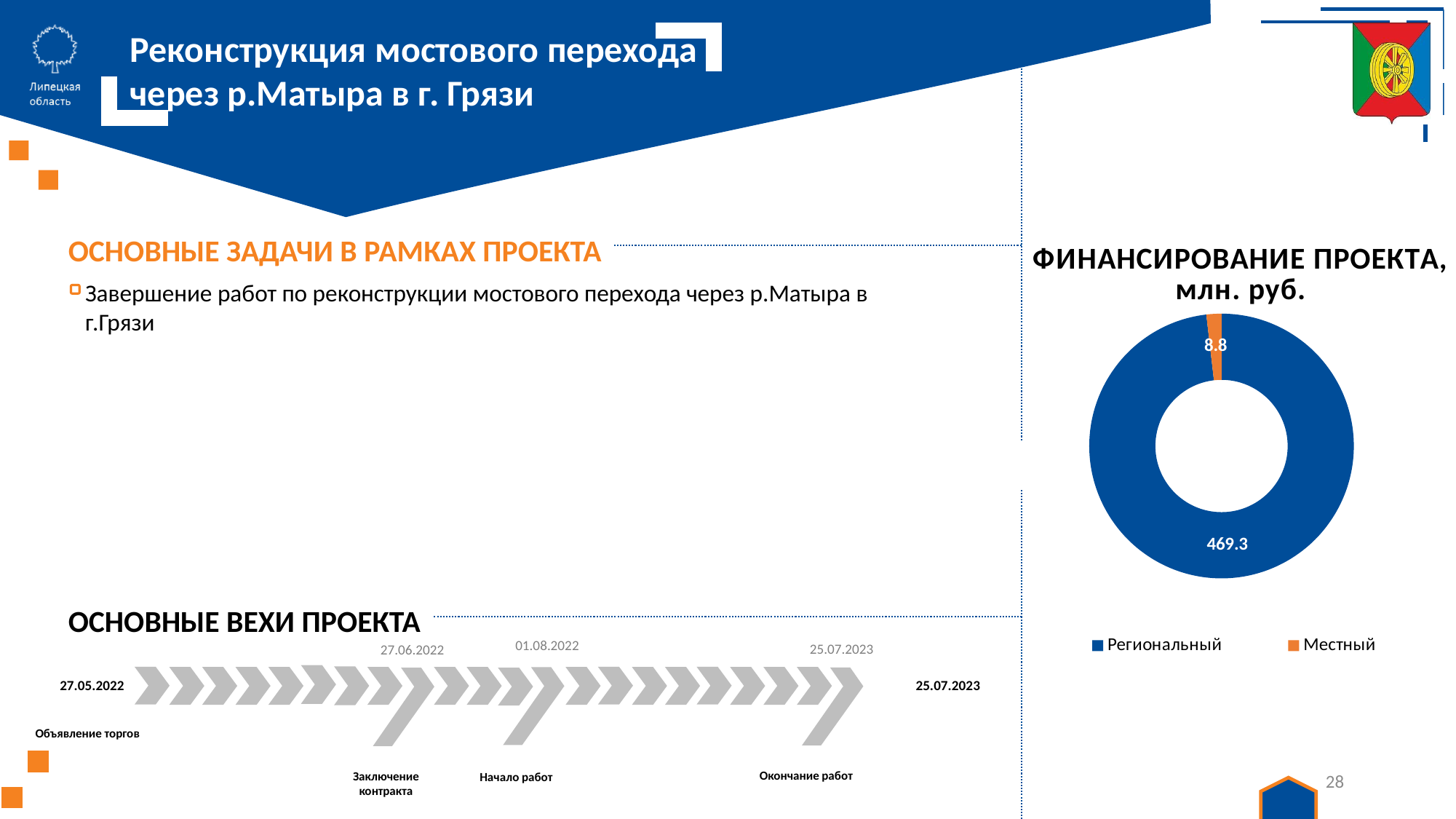
How many categories does the financing chart show? 2 Which funding source has the smallest share in the financing chart? Местный Which funding source has the largest share in the financing chart? Региональный What type of chart is used to show the project financing? Doughnut (pie) chart How many entries does the legend of the financing chart list? 2 What is the title of the financing chart? ФИНАНСИРОВАНИЕ ПРОЕКТА, млн. руб. Which is larger in the financing chart: Региональный or Местный? Региональный What colour represents Местный in the financing chart? Orange What is the total of the two values shown in the financing chart? 478.1 What is the value for Местный in the financing chart? 8.8 What is the difference between the Региональный and Местный values in the financing chart? 460.5 What is the value for Региональный in the financing chart? 469.3